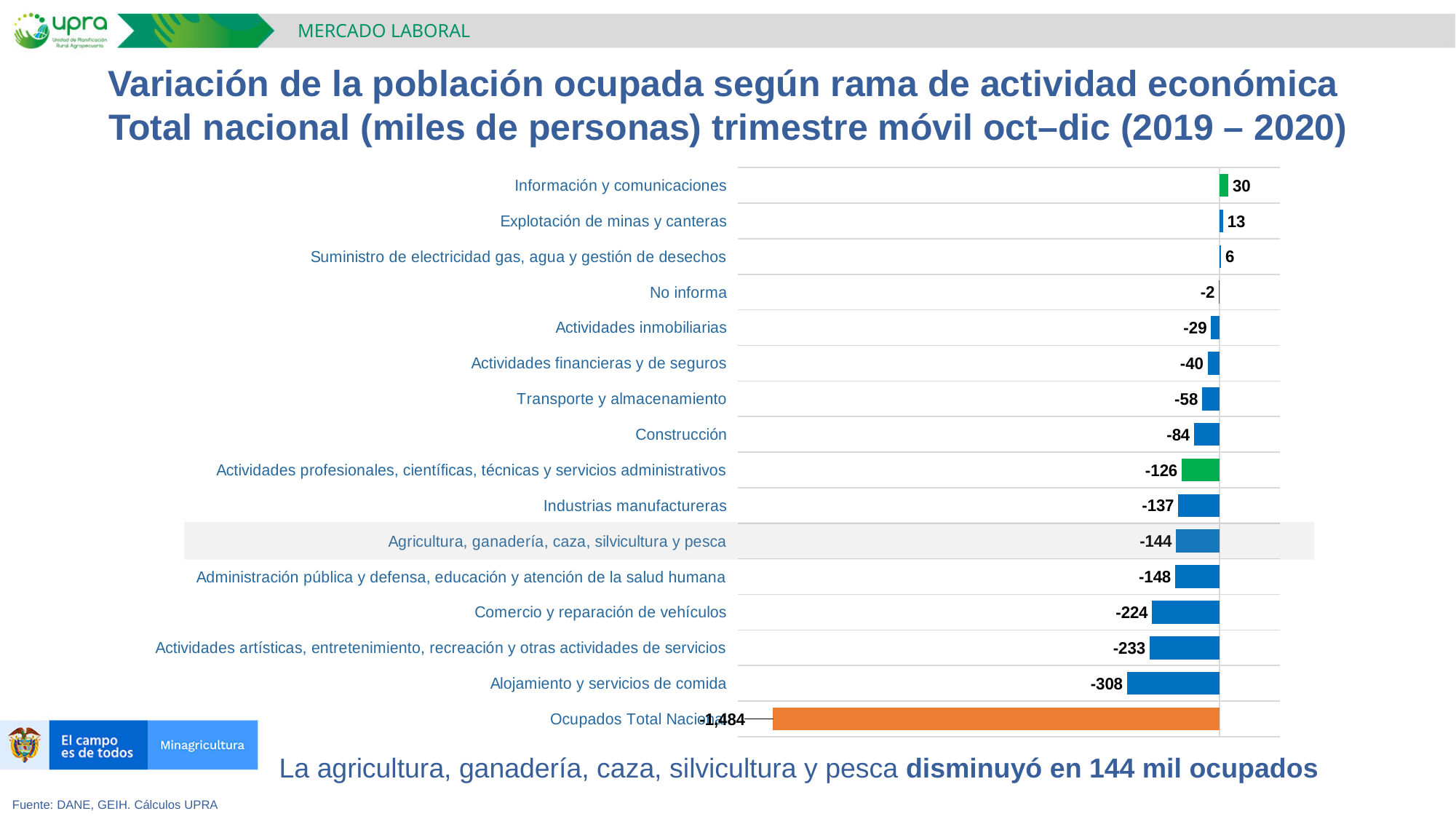
What is the value for Agricultura, ganadería, caza, silvicultura y pesca? -144 Which category has the lowest value? Ocupados Total Nacional What colour is the bar for Ocupados Total Nacional? Orange What kind of chart is shown on the slide? Bar chart Which is larger, the value for Explotación de minas y canteras or the value for Suministro de electricidad gas, agua y gestión de desechos? Explotación de minas y canteras What is the value for Construcción? -84 Which category has the highest value? Información y comunicaciones What is the difference between the values for Comercio y reparación de vehículos and Actividades artísticas, entretenimiento, recreación y otras actividades de servicios? 9 How many categories are shown in the chart? 16 What is the value for Información y comunicaciones? 30 What is the value for Alojamiento y servicios de comida? -308 What is the difference between the values for Industrias manufactureras and Agricultura, ganadería, caza, silvicultura y pesca? 7